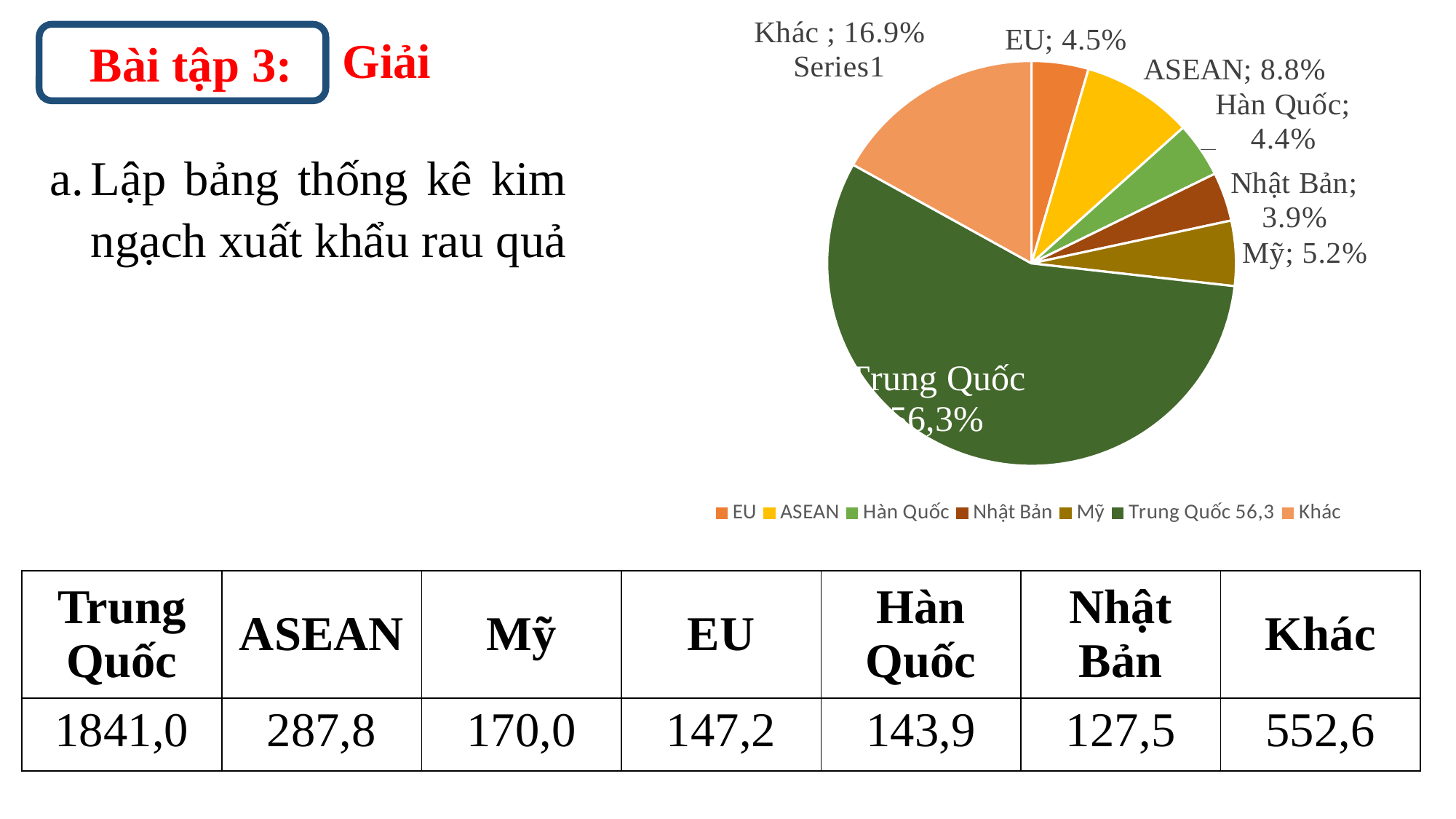
Which is larger in the pie chart, ASEAN or Mỹ? ASEAN Which slice of the pie chart is the largest? Trung Quốc What kind of chart is shown on the slide? pie chart What percentage does the pie chart show for EU? 4.5% What percentage does the pie chart show for Mỹ? 5.2% What percentage does the pie chart show for Khác? 16.9% Which slice of the pie chart is the smallest? Nhật Bản What percentage does the pie chart show for ASEAN? 8.8% What is the difference in percentage points between Khác and ASEAN in the pie chart? 8.1 How many slices does the pie chart have? 7 How many entries does the pie chart's legend list? 7 What percentage does the pie chart show for Nhật Bản? 3.9%